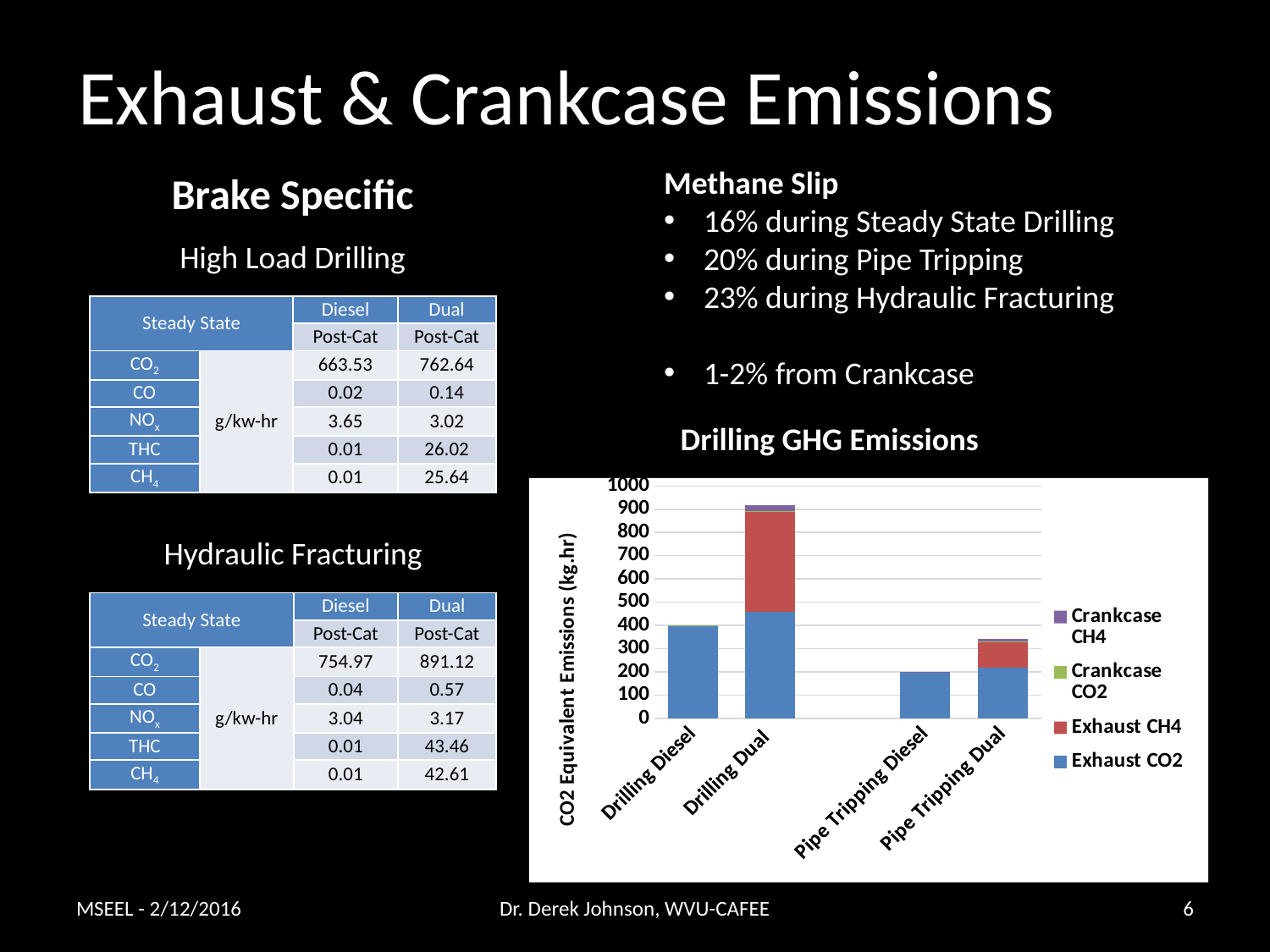
How many series does the legend of the Drilling GHG Emissions chart list? 4 In the Drilling GHG Emissions chart, is the value for Drilling Diesel greater or less than 300? greater In the Drilling GHG Emissions chart, is the total for Pipe Tripping Dual greater or less than 400? less What kind of chart is shown under the title "Drilling GHG Emissions"? Stacked bar chart How many categories are shown on the x axis of the Drilling GHG Emissions chart? 4 In the Drilling GHG Emissions chart, which category has the tallest stacked bar? Drilling Dual What is the y-axis label of the Drilling GHG Emissions chart? CO2 Equivalent Emissions (kg.hr) In the Drilling GHG Emissions chart, which has the larger total: Drilling Diesel or Pipe Tripping Dual? Drilling Diesel In the Drilling GHG Emissions chart, is the value for Pipe Tripping Diesel greater or less than 300? less In the Drilling GHG Emissions chart, which category has the shortest stacked bar? Pipe Tripping Diesel In the Drilling GHG Emissions chart, which series is shown in blue? Exhaust CO2